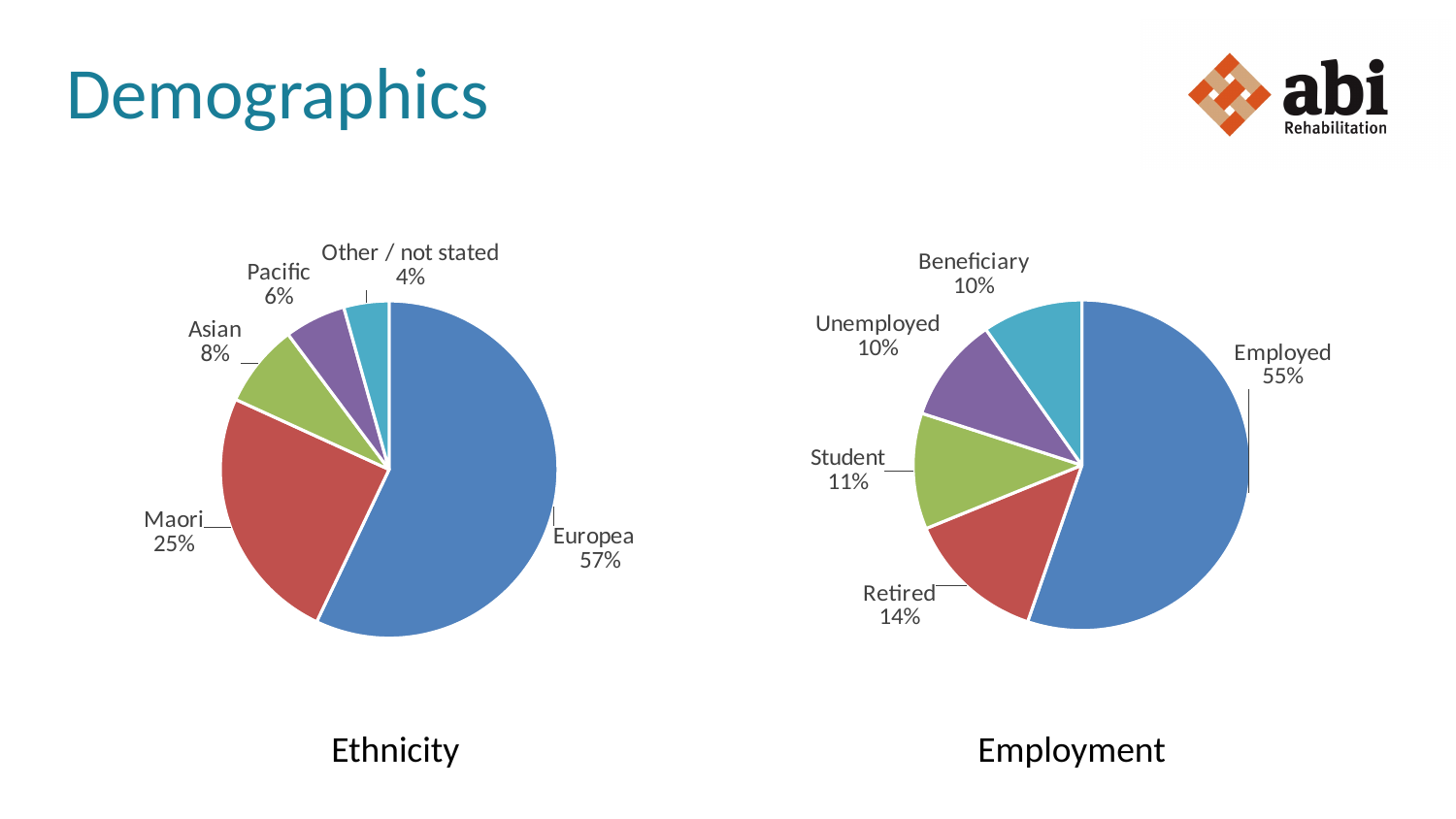
In the Ethnicity pie chart, how many slices are there? 5 What type of chart is used for the Employment data? Pie chart In the Employment pie chart, which is larger, the Retired slice or the Student slice? Retired In the Ethnicity pie chart, what share is labelled for Asian? 8% In the Ethnicity pie chart, what share is labelled for Maori? 25% In the Employment pie chart, how many categories are shown? 5 In the Employment pie chart, which category has the largest slice? Employed In the Ethnicity pie chart, what is the difference between the Europea and Maori shares? 32% In the Ethnicity pie chart, which category has the largest slice? Europea In the Employment pie chart, what share is labelled for Student? 11% In the Ethnicity pie chart, which category has the smallest slice? Other / not stated In the Employment pie chart, what share is labelled for Retired? 14%